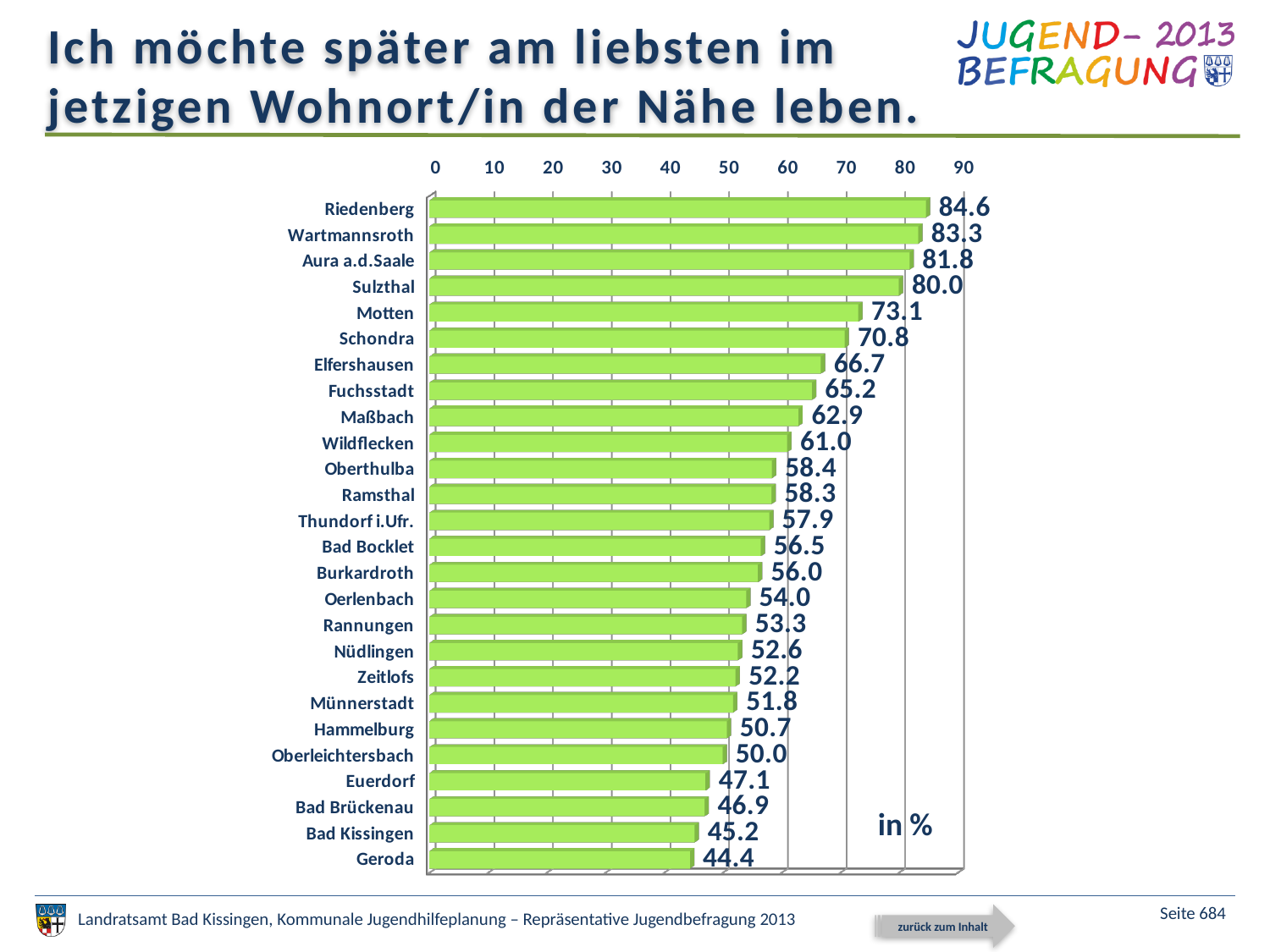
What is the difference between the values for Sulzthal and Motten? 6.9 What is the value for Oberthulba? 58.4 What is the value for Bad Kissingen? 45.2 What unit are the values given in, according to the label inside the chart? in % What is the value for Riedenberg? 84.6 Which has a larger value, Schondra or Fuchsstadt? Schondra Which municipality has the lowest value? Geroda Which municipality has the highest value? Riedenberg What kind of chart is shown on the slide? Bar chart How many municipalities are shown in the chart? 26 Which has a larger value, Euerdorf or Hammelburg? Hammelburg What is the difference between the values for Riedenberg and Geroda? 40.2